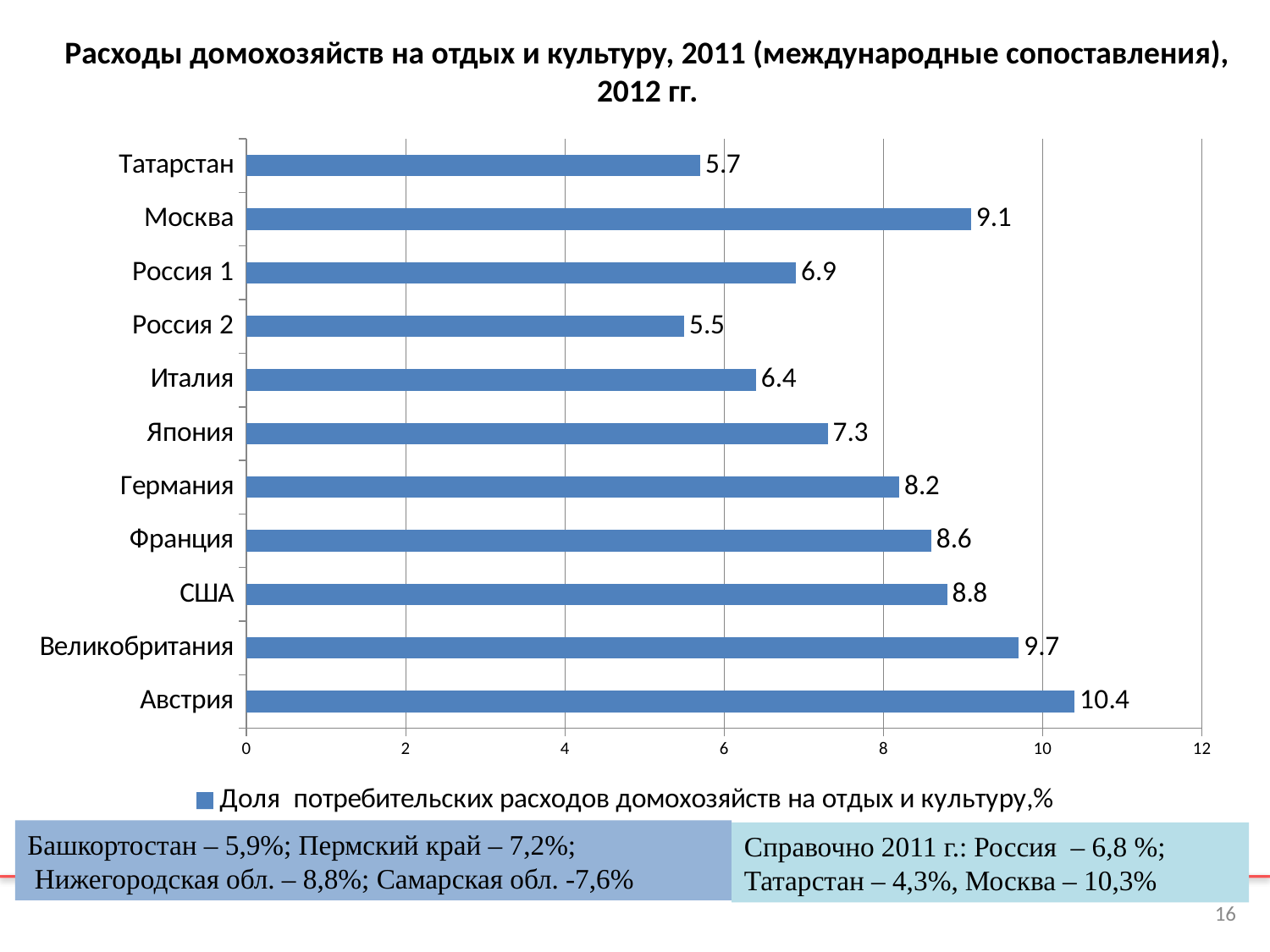
Which category has the highest value? Австрия What is the value for Москва? 9.1 Is the value for США greater or less than 8? greater What is the legend entry of the chart? Доля потребительских расходов домохозяйств на отдых и культуру,% Which category has the lowest value? Россия 2 Which is larger, the value for Германия or the value for Франция? Франция What is the value for Австрия? 10.4 What is the difference between the values for Великобритания and Татарстан? 4 How many categories are shown in the chart? 11 How many series does the legend list? 1 What is the value for Япония? 7.3 What kind of chart is shown on the slide? bar chart